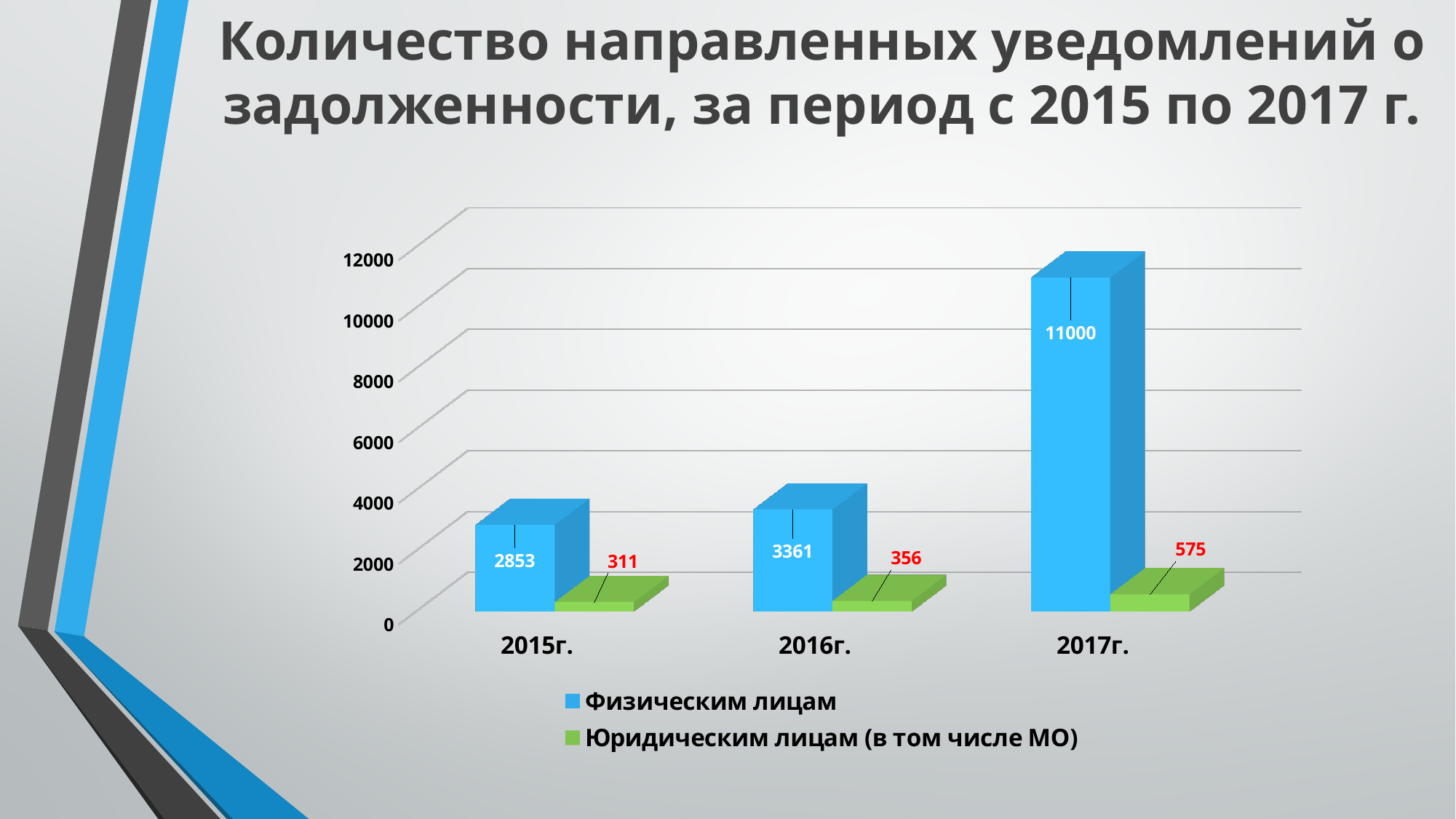
What is the value for Физическим лицам in 2016г.? 3361 Does the value for Физическим лицам in 2017г. rise or fall compared with 2016г.? rise How many years are shown on the x axis? 3 What is the value for Юридическим лицам (в том числе МО) in 2015г.? 311 How many series does the legend list? 2 What kind of chart is shown on the slide? bar chart Which is larger: the Юридическим лицам (в том числе МО) value for 2016г. or for 2015г.? 2016г. What is the value for Юридическим лицам (в том числе МО) in 2017г.? 575 What is the value for Физическим лицам in 2017г.? 11000 What is the difference between the Физическим лицам values for 2016г. and 2015г.? 508 In which year is the value for Физическим лицам highest? 2017г. In which year is the value for Юридическим лицам (в том числе МО) lowest? 2015г.